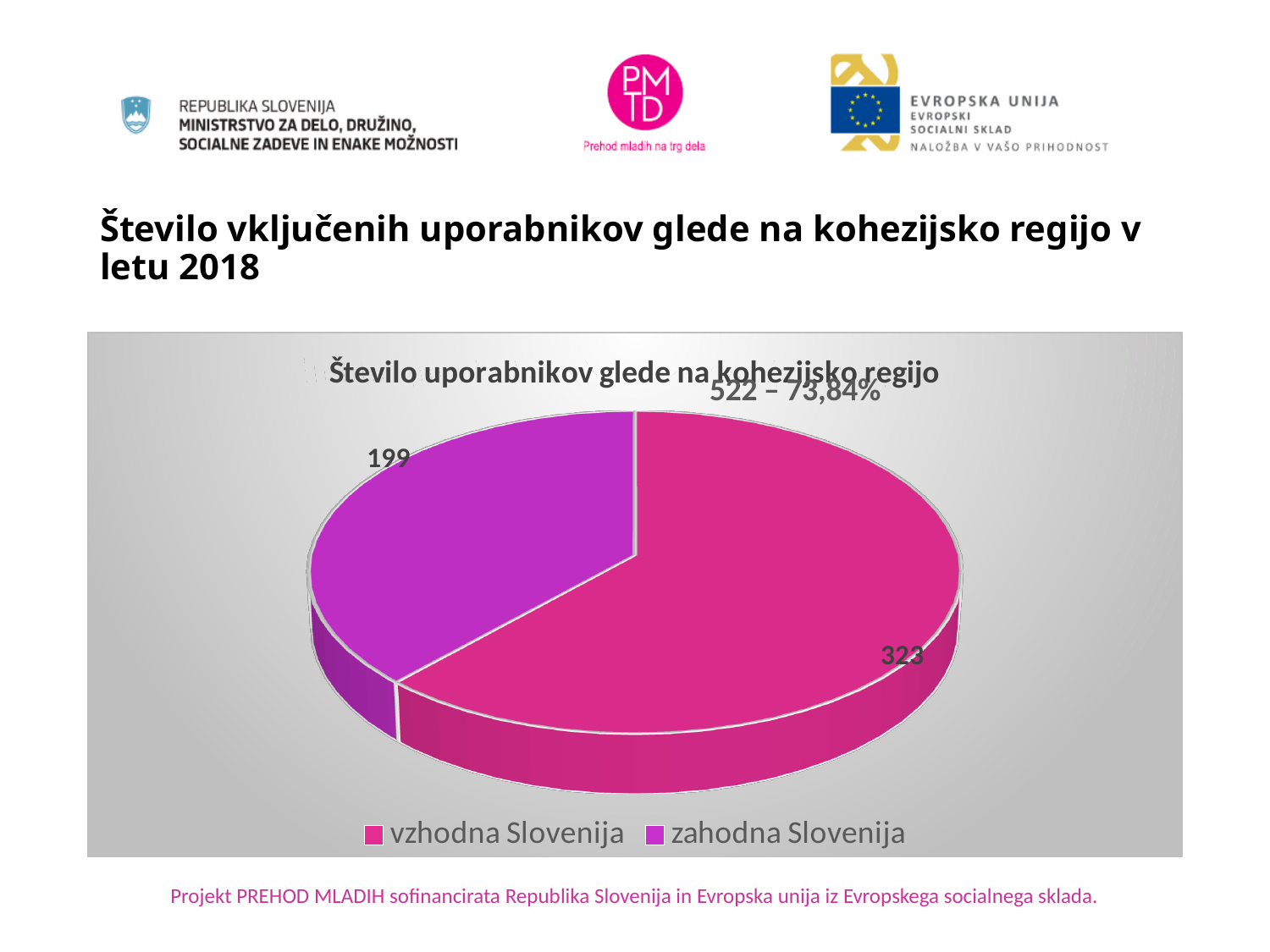
What is the value for zahodna Slovenija? 199 How many slices does the pie chart have? 2 What is the difference between the values for vzhodna Slovenija and zahodna Slovenija? 124 Which region has the smaller slice of the pie? zahodna Slovenija Which is larger, the value for vzhodna Slovenija or the value for zahodna Slovenija? vzhodna Slovenija Which colour represents zahodna Slovenija in the legend? purple What kind of chart is shown on the slide? pie chart How many entries does the legend list? 2 What is the value for vzhodna Slovenija? 323 Which region has the larger slice of the pie? vzhodna Slovenija What is the total of the two slices in the pie chart? 522